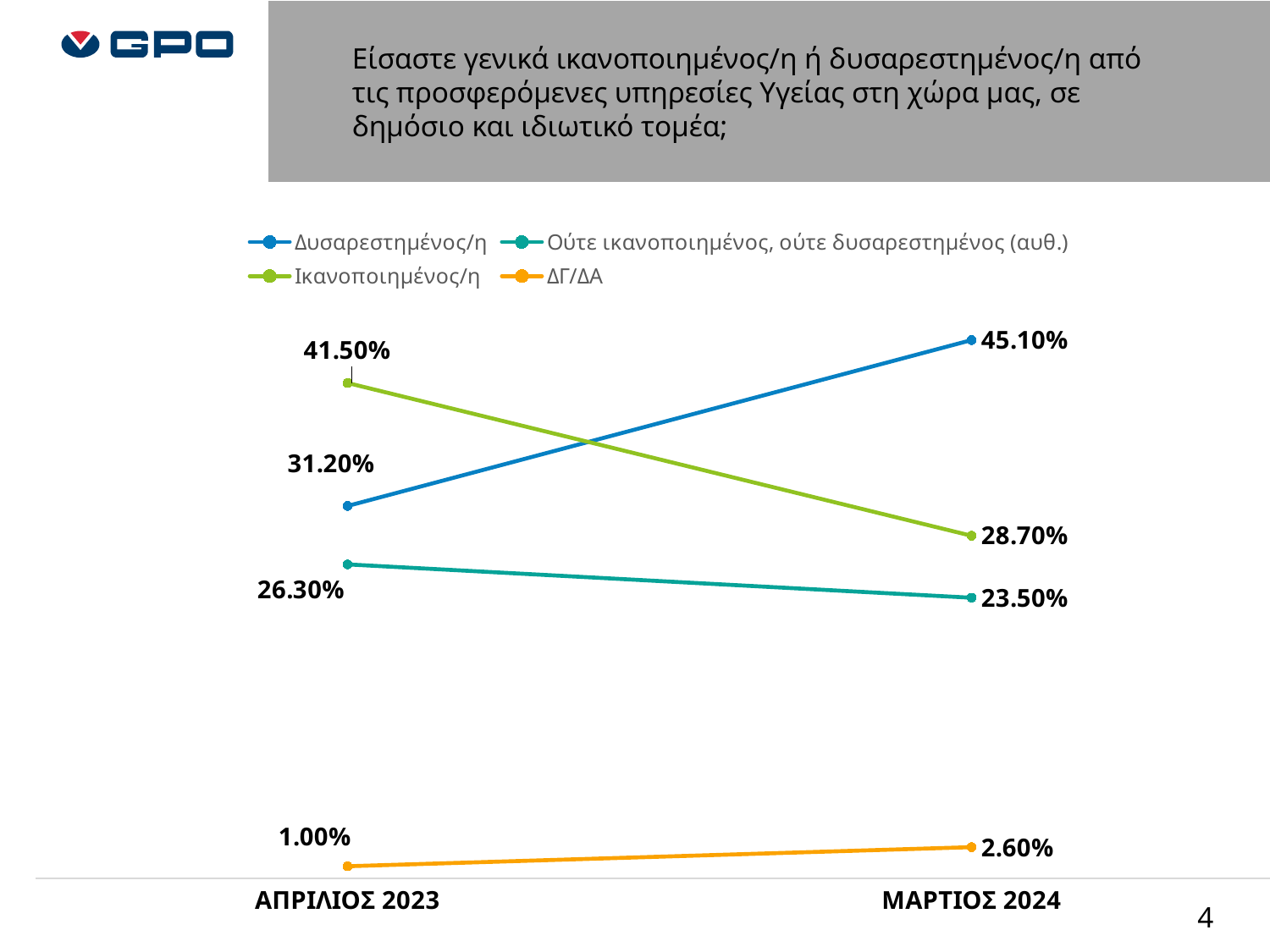
What is the value for Ικανοποιημένος/η in ΑΠΡΙΛΙΟΣ 2023? 41.50% Does the value for Ικανοποιημένος/η rise or fall from ΑΠΡΙΛΙΟΣ 2023 to ΜΑΡΤΙΟΣ 2024? fall What is the value for ΔΓ/ΔΑ in ΜΑΡΤΙΟΣ 2024? 2.60% By how much did the value for Δυσαρεστημένος/η change from ΑΠΡΙΛΙΟΣ 2023 to ΜΑΡΤΙΟΣ 2024? 13.90% What type of chart is shown on the slide? line chart How many series does the legend list? 4 What is the value for Ούτε ικανοποιημένος, ούτε δυσαρεστημένος (αυθ.) in ΑΠΡΙΛΙΟΣ 2023? 26.30% Which series has the lowest value in ΑΠΡΙΛΙΟΣ 2023? ΔΓ/ΔΑ Which is larger in ΑΠΡΙΛΙΟΣ 2023: Δυσαρεστημένος/η or Ικανοποιημένος/η? Ικανοποιημένος/η What is the value for Δυσαρεστημένος/η in ΜΑΡΤΙΟΣ 2024? 45.10% Which series has the highest value in ΜΑΡΤΙΟΣ 2024? Δυσαρεστημένος/η How many time points are shown on the x axis? 2